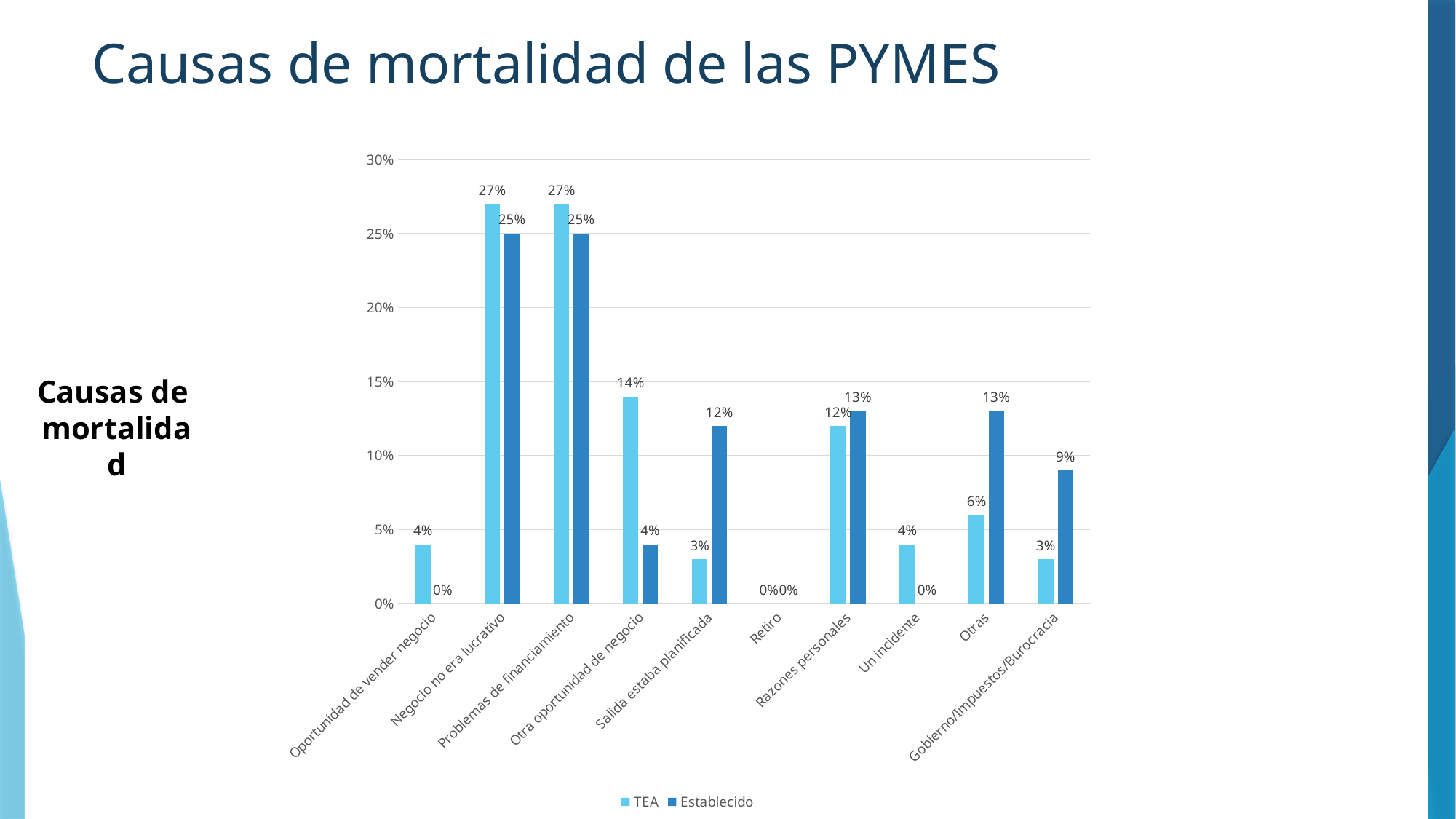
What is the difference between the TEA and Establecido values for Otra oportunidad de negocio? 10% What is the Establecido value for Gobierno/Impuestos/Burocracia? 9% What is the difference between the Establecido and TEA values for Otras? 7% How many categories are shown on the x axis? 10 What is the TEA value for Otra oportunidad de negocio? 14% Which category has the lowest TEA value? Retiro How many series does the legend list? 2 For Un incidente, which series has the larger value, TEA or Establecido? TEA What is the Establecido value for Salida estaba planificada? 12% What are the names of the two series in the legend? TEA and Establecido What type of chart is shown on the slide? bar chart For Salida estaba planificada, which series has the larger value, TEA or Establecido? Establecido